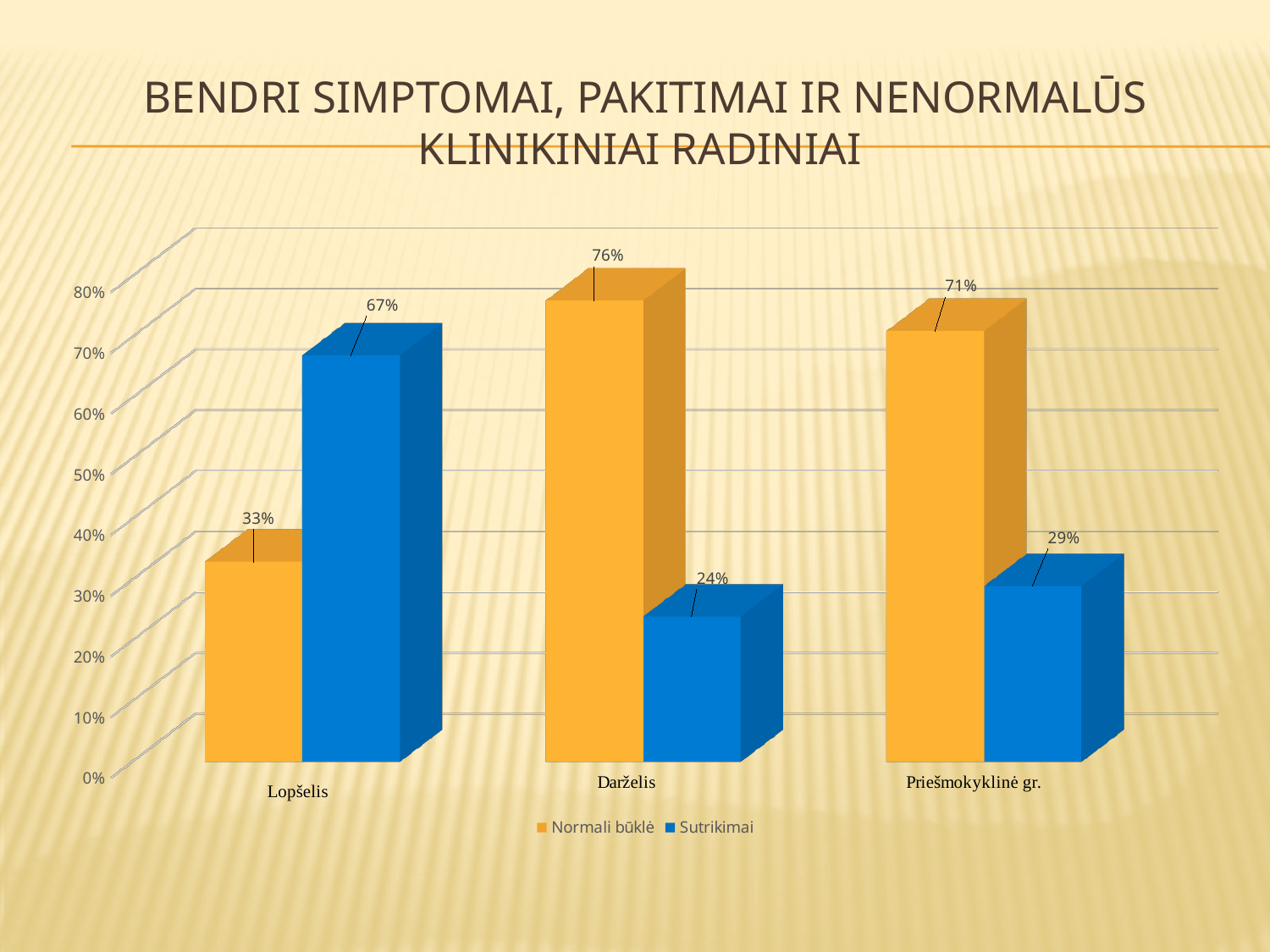
How many series does the legend list? 2 What is the difference between Normali būklė and Sutrikimai for Priešmokyklinė gr.? 42% Which category has the highest Normali būklė value? Darželis Which category has the lowest Sutrikimai value? Darželis For Lopšelis, which is larger: Normali būklė or Sutrikimai? Sutrikimai What is the value of Sutrikimai for Lopšelis? 67% How many categories are shown on the x axis? 3 What colour represents the Sutrikimai series? Blue What is the value of Sutrikimai for Darželis? 24% What is the value of Normali būklė for Priešmokyklinė gr.? 71% What is the value of Normali būklė for Lopšelis? 33% What kind of chart is shown on the slide? Bar chart